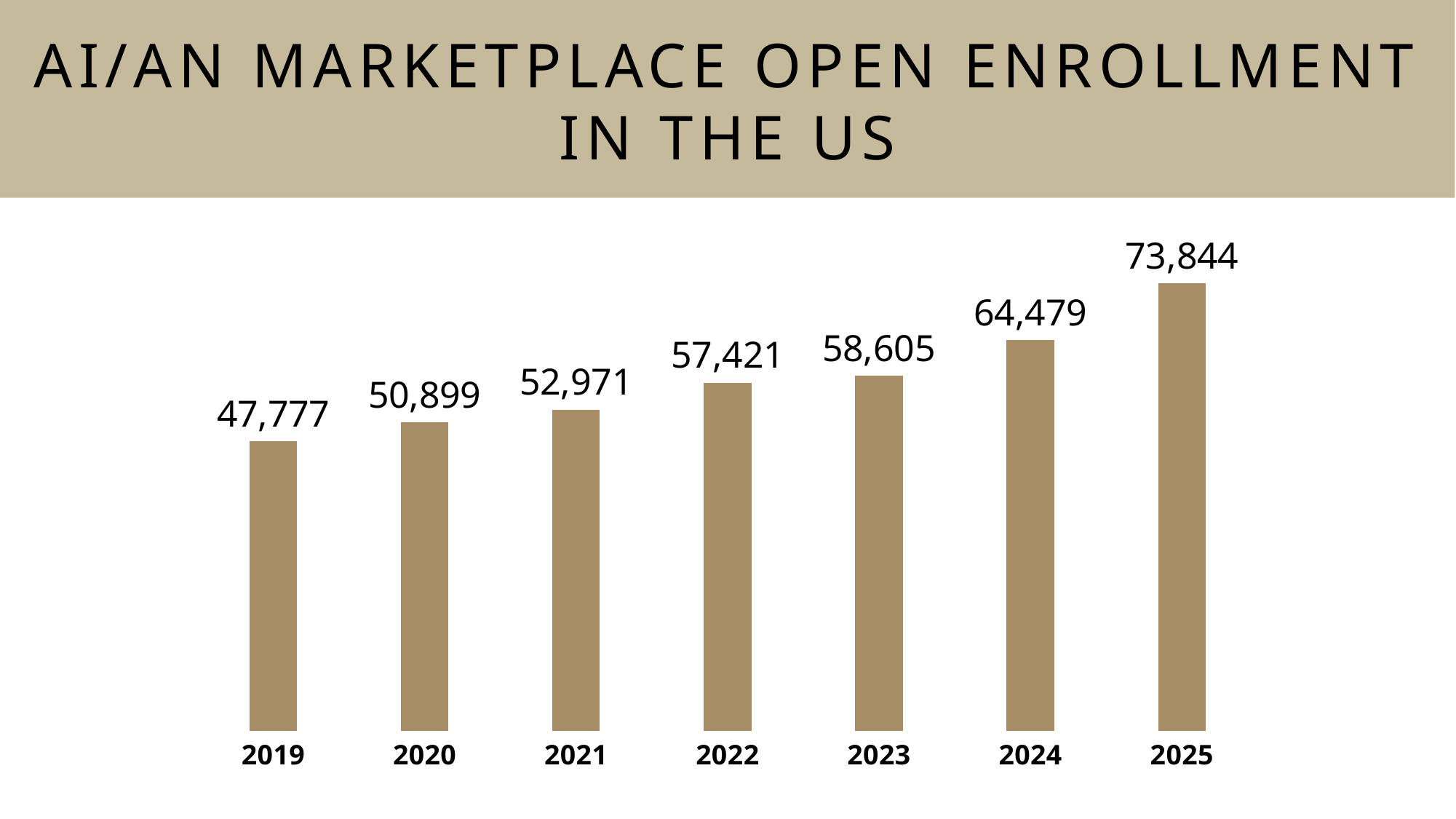
Which year has the larger enrollment, 2021 or 2023? 2023 How many years are shown on the chart? 7 What is the AI/AN Marketplace open enrollment value for 2019? 47,777 What is the difference in enrollment between 2025 and 2024? 9,365 What is the title of the chart? AI/AN Marketplace Open Enrollment in the US What is the enrollment value shown for 2024? 64,479 What is the difference in enrollment between 2020 and 2019? 3,122 Which year has the lowest enrollment? 2019 What is the enrollment value shown for 2022? 57,421 Do the enrollment values rise or fall from 2019 to 2025? Rise What kind of chart is shown on the slide? Bar chart Which year has the highest enrollment? 2025